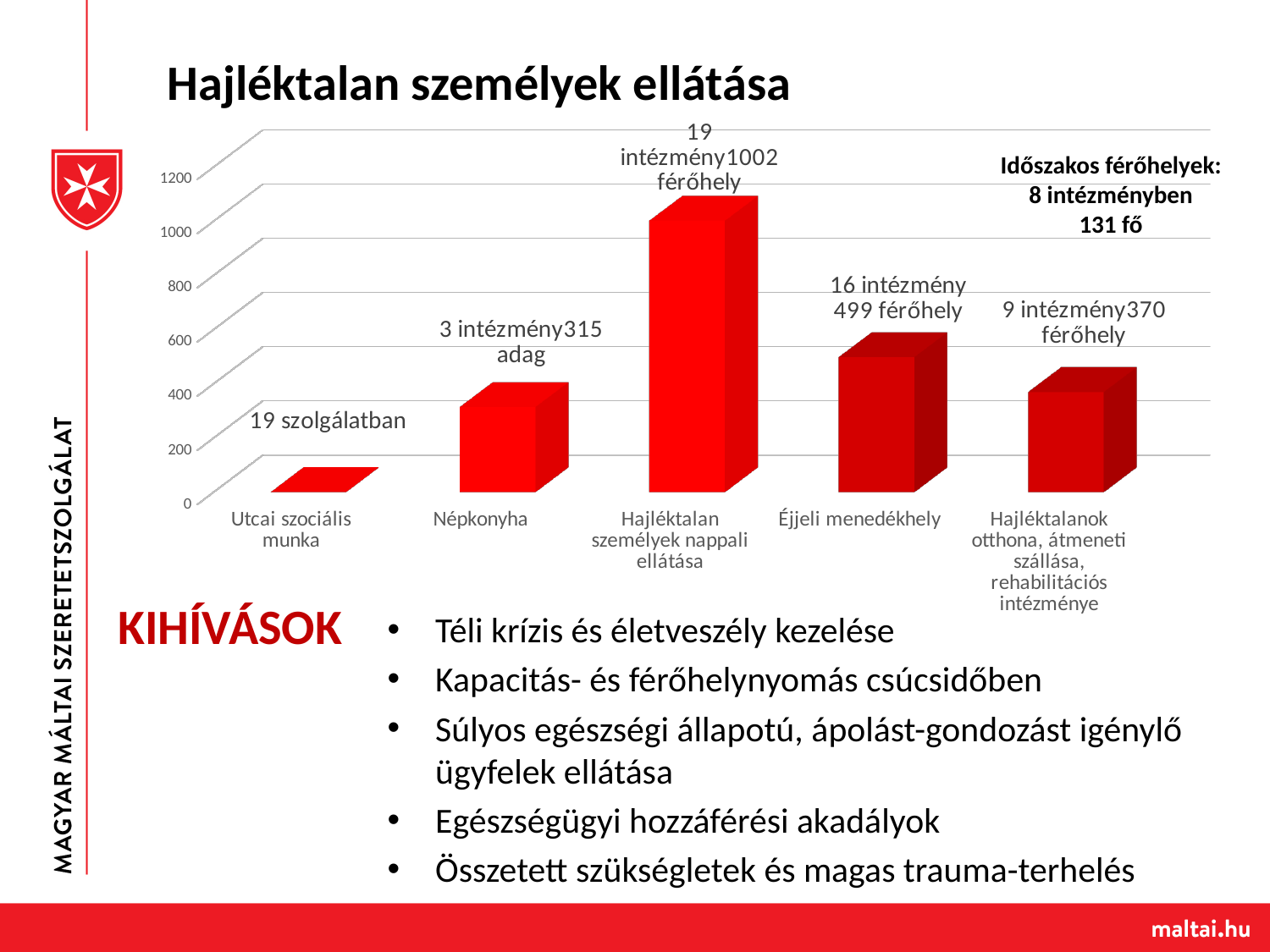
Is the value for Utcai szociális munka greater or less than 200? less How many categories are shown on the x axis of the chart? 5 What is the title of the slide above the chart? Hajléktalan személyek ellátása How many adag are labelled for Népkonyha? 315 adag How many férőhely are labelled for Hajléktalan személyek nappali ellátása? 1002 férőhely What kind of chart is shown on the slide? bar chart Which category has the highest bar in the chart? Hajléktalan személyek nappali ellátása How many intézmény are labelled for Hajléktalanok otthona, átmeneti szállása, rehabilitációs intézménye? 9 intézmény Which category has the lowest bar in the chart? Utcai szociális munka Which bar is taller: Népkonyha or Hajléktalanok otthona, átmeneti szállása, rehabilitációs intézménye? Hajléktalanok otthona, átmeneti szállása, rehabilitációs intézménye What is the difference in férőhely between Hajléktalan személyek nappali ellátása (1002) and Éjjeli menedékhely (499)? 503 How many férőhely are labelled for Éjjeli menedékhely? 499 férőhely